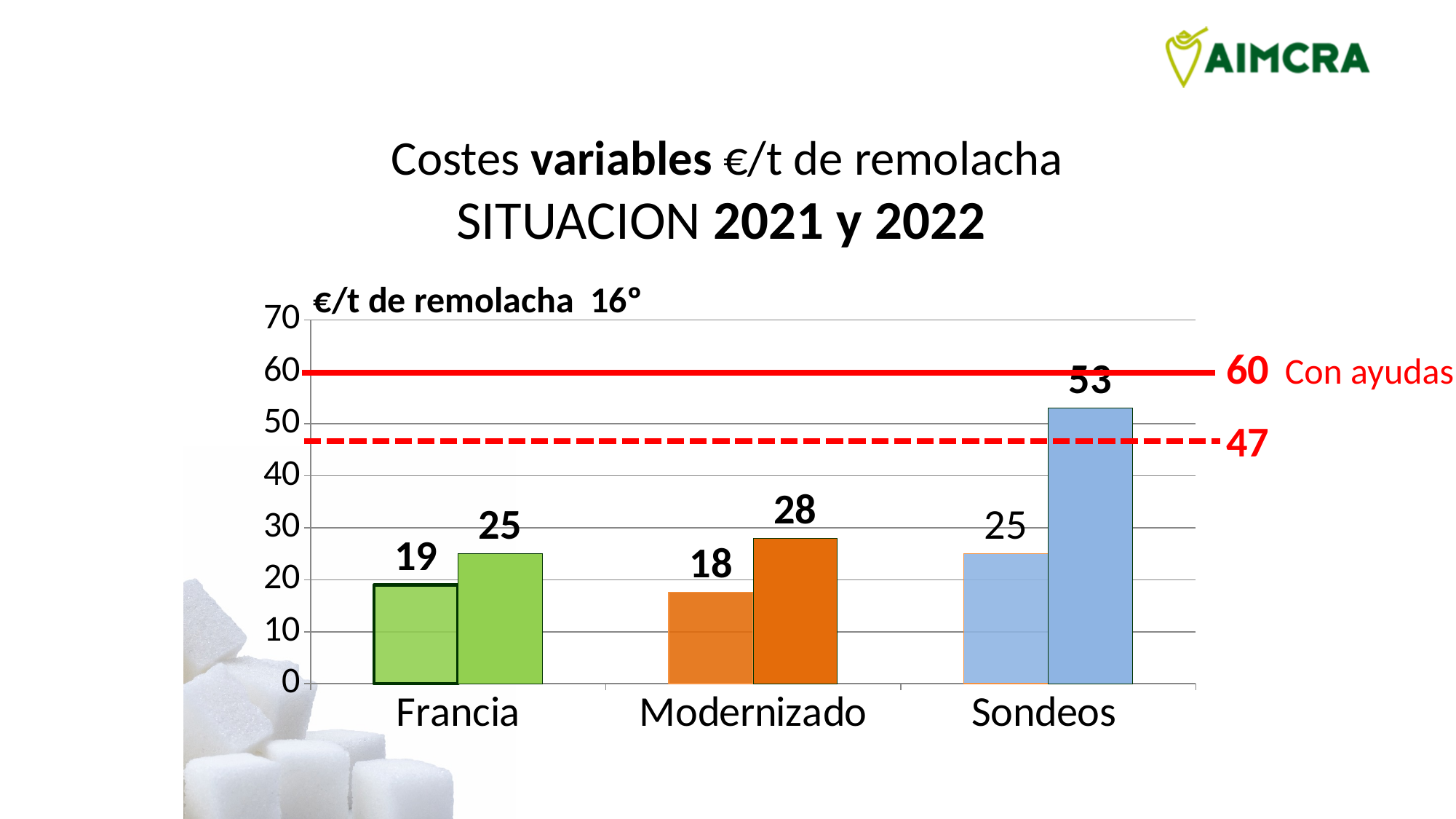
What is the value of the right bar for Modernizado? 28 What is the value of the right bar for Sondeos? 53 How many categories are shown on the x axis? 3 Which is larger: the right bar for Francia or the right bar for Modernizado? Modernizado What value is marked by the solid red horizontal line labelled 'Con ayudas'? 60 What is the value of the left bar for Francia? 19 What is the difference between the right bar and the left bar for Francia? 6 What is the value of the left bar for Modernizado? 18 What is the difference between the right bar and the left bar for Sondeos? 28 What kind of chart is shown on the slide? Bar chart Which category has the lowest left bar? Modernizado Which category has the highest right bar? Sondeos